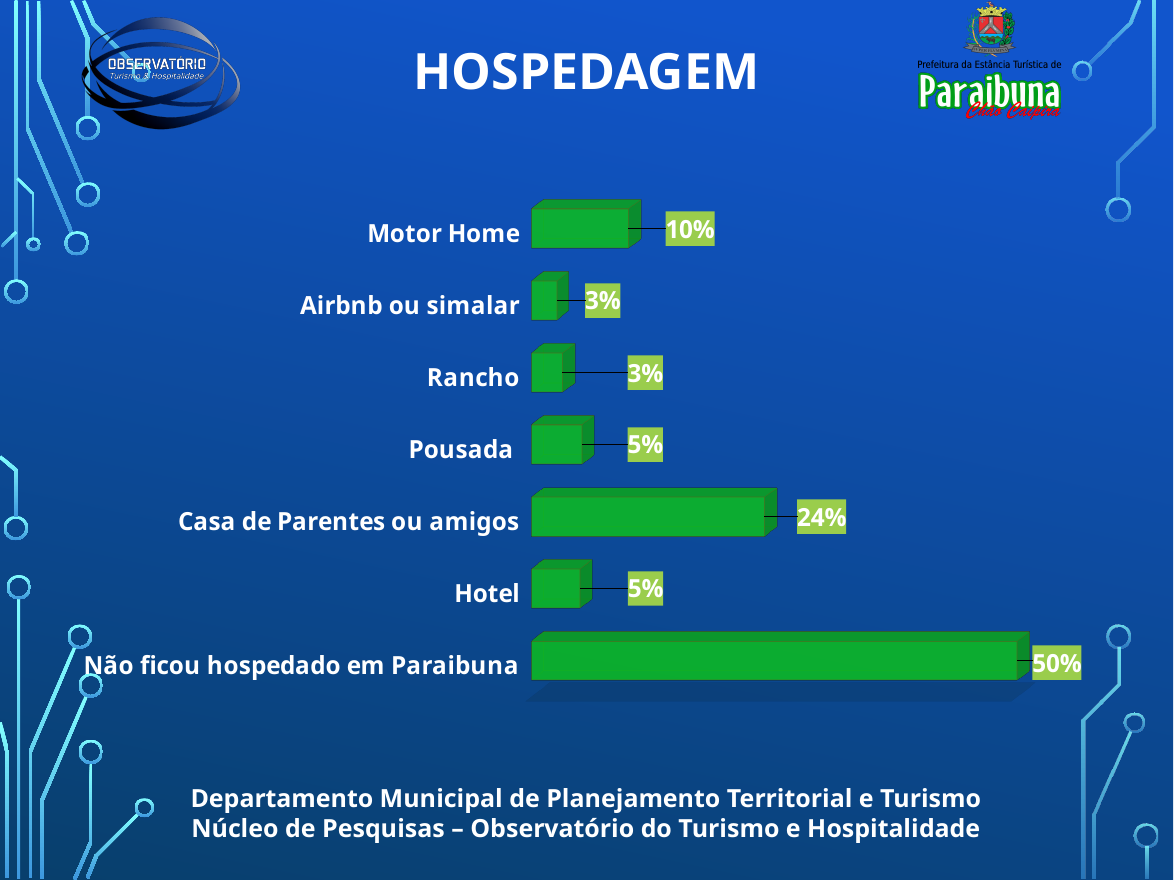
Which is larger, Casa de Parentes ou amigos or Pousada? Casa de Parentes ou amigos What is the title of the chart? HOSPEDAGEM What kind of chart is shown on the slide? Bar chart How many categories are shown in the chart? 7 What is the value for Motor Home? 10% What is the value for Casa de Parentes ou amigos? 24% Which category has the highest value? Não ficou hospedado em Paraibuna What is the value for Não ficou hospedado em Paraibuna? 50% What is the difference between Motor Home and Pousada? 5% Which is larger, Motor Home or Hotel? Motor Home What is the value for Hotel? 5% What is the difference between Não ficou hospedado em Paraibuna and Casa de Parentes ou amigos? 26%